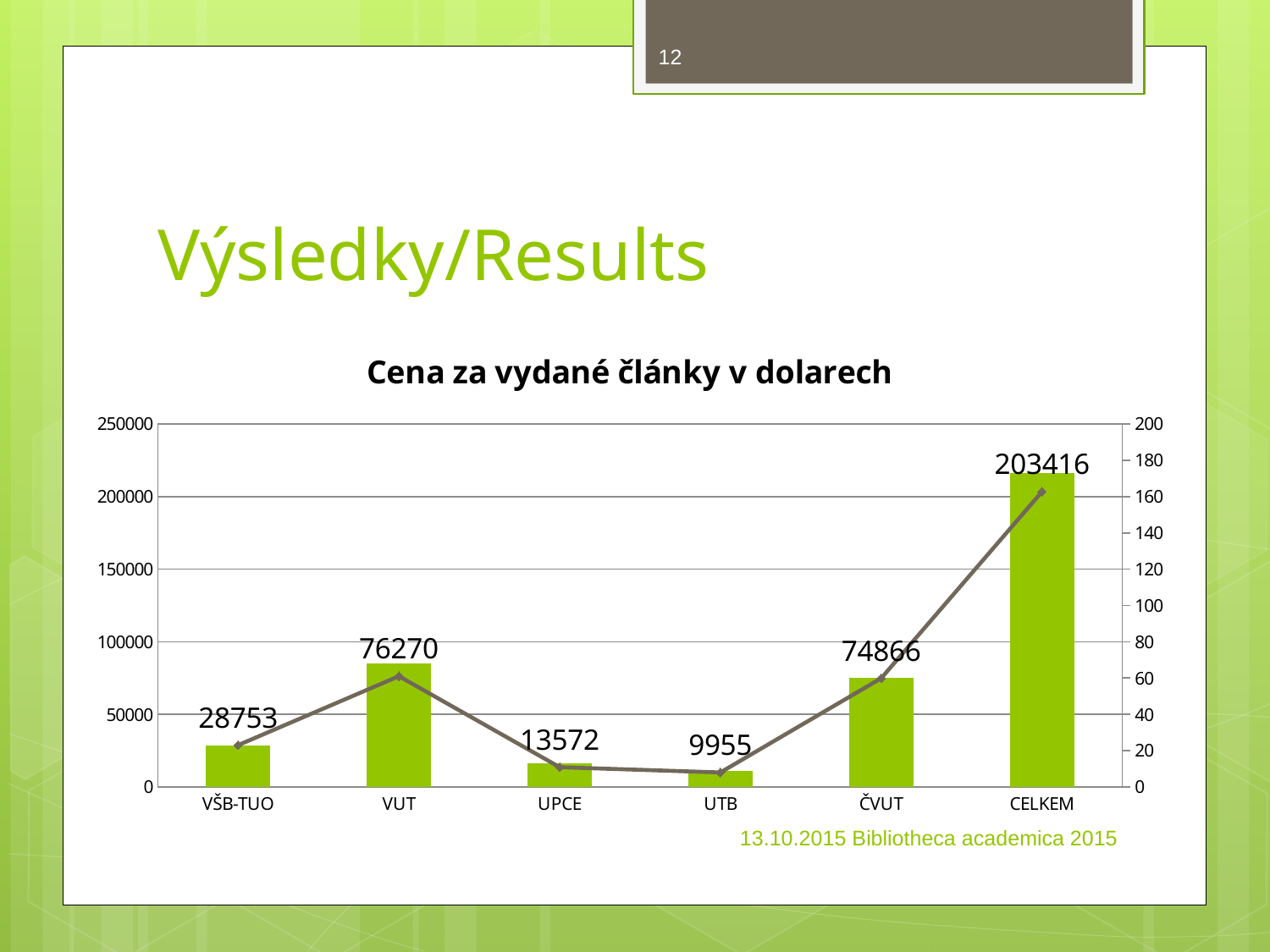
How many categories are shown on the x axis? 6 What is the value shown for CELKEM? 203416 What is the difference between the values for UPCE and UTB? 3617 What is the difference between the values for VUT and VŠB-TUO? 47517 Which category has the highest bar value? CELKEM Which is larger, the value for VUT or the value for ČVUT? VUT On the right-hand axis, is the line point for CELKEM greater or less than 140? greater What is the value shown for ČVUT? 74866 What is the value for VUT in the chart 'Cena za vydané články v dolarech'? 76270 Which category has the lowest bar value? UTB What is the title of the chart? Cena za vydané články v dolarech What is the value shown for UTB? 9955